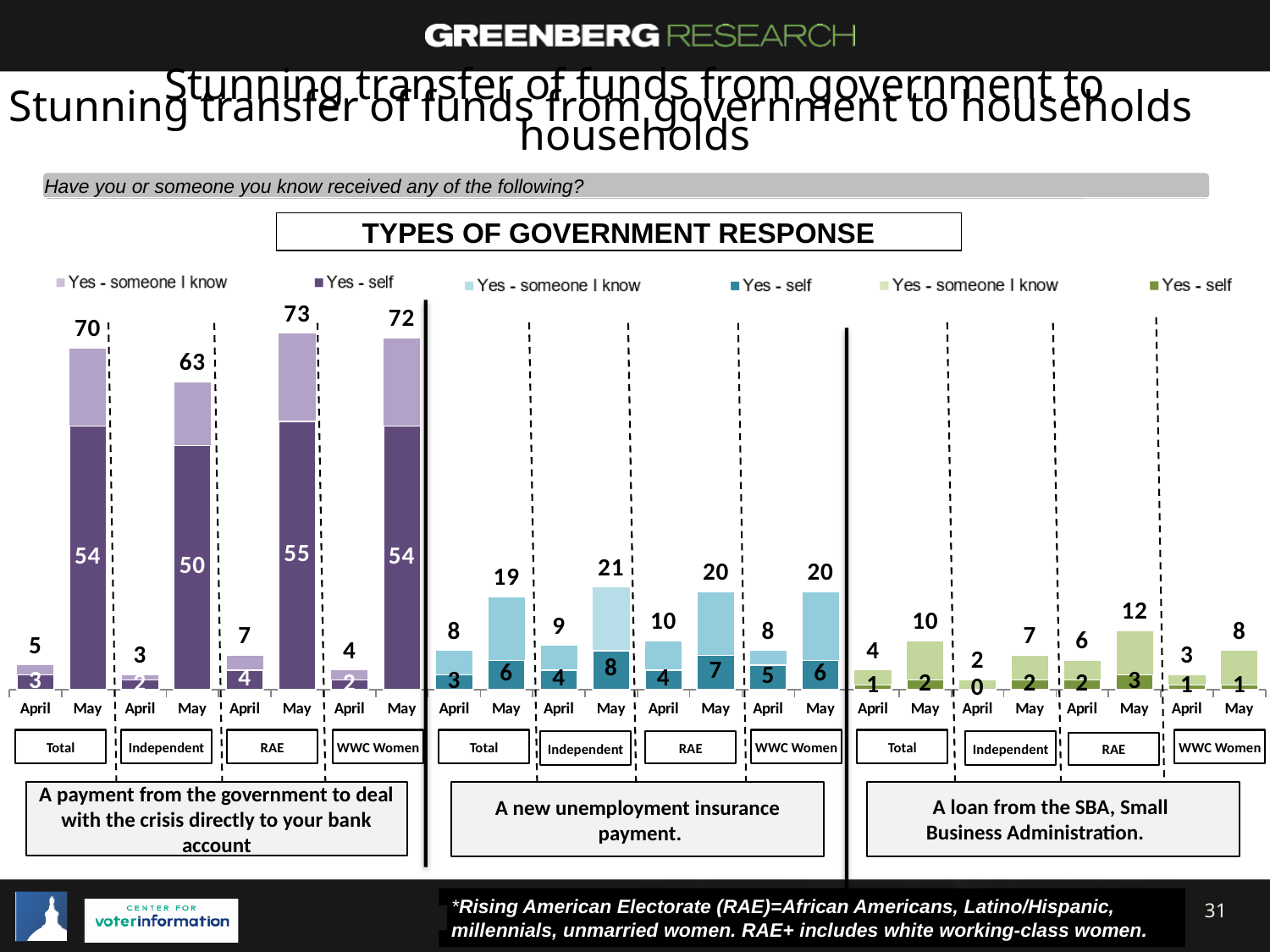
What kind of chart is used for 'A loan from the SBA, Small Business Administration'? Stacked bar chart In the chart for 'A new unemployment insurance payment', what is the total value of the April bar for RAE? 10 In the chart for 'A payment from the government to deal with the crisis directly to your bank account', which group has the highest May bar? RAE How many series does the legend list for the chart for 'A new unemployment insurance payment'? 2 In the chart for 'A loan from the SBA, Small Business Administration', which group has the lowest April bar? Independent In the chart for 'A loan from the SBA, Small Business Administration', what is the 'Yes - self' value for Independent in April? 0 In the chart for 'A payment from the government to deal with the crisis directly to your bank account', what is the difference between the May and April totals for Total? 65 In the chart for 'A new unemployment insurance payment', is the May total for Independent larger or smaller than the May total for Total? larger In the chart for 'A payment from the government to deal with the crisis directly to your bank account', what is the total value of the May bar for Total? 70 In the chart for 'A loan from the SBA, Small Business Administration', what is the total value of the May bar for RAE? 12 In the chart for 'A payment from the government to deal with the crisis directly to your bank account', what is the 'Yes - self' value for RAE in May? 55 In the chart for 'A new unemployment insurance payment', what is the 'Yes - self' value for Independent in May? 8